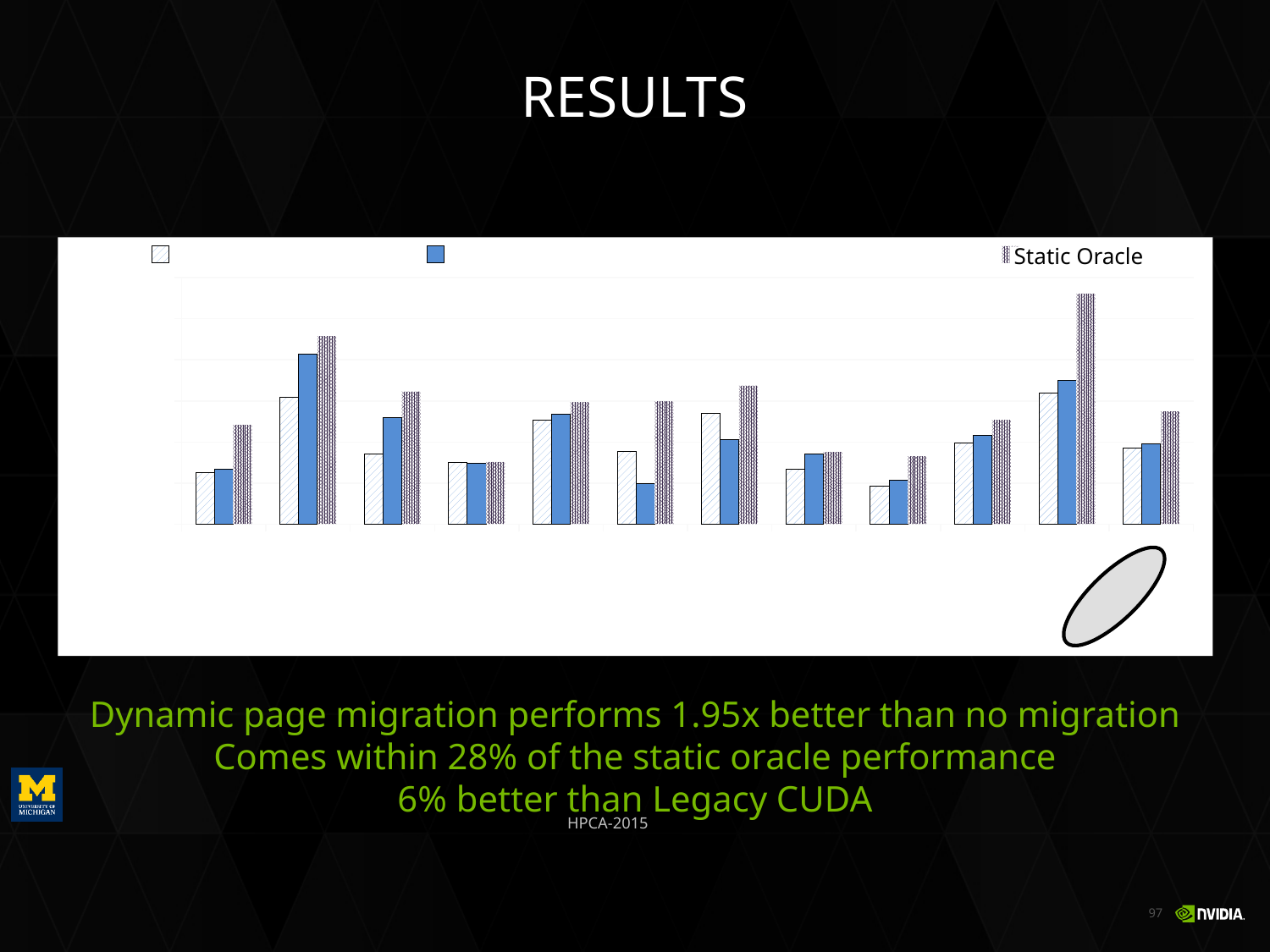
What is the name of the series shown with the patterned bars, as given in the legend? Static Oracle How many groups of bars (categories) are plotted on the chart? 12 What colour are the bars of the second (middle) series in each group? blue How many series does the chart's legend list? 3 What kind of chart is shown on the slide? bar chart Which series does the tallest bar on the chart belong to? Static Oracle